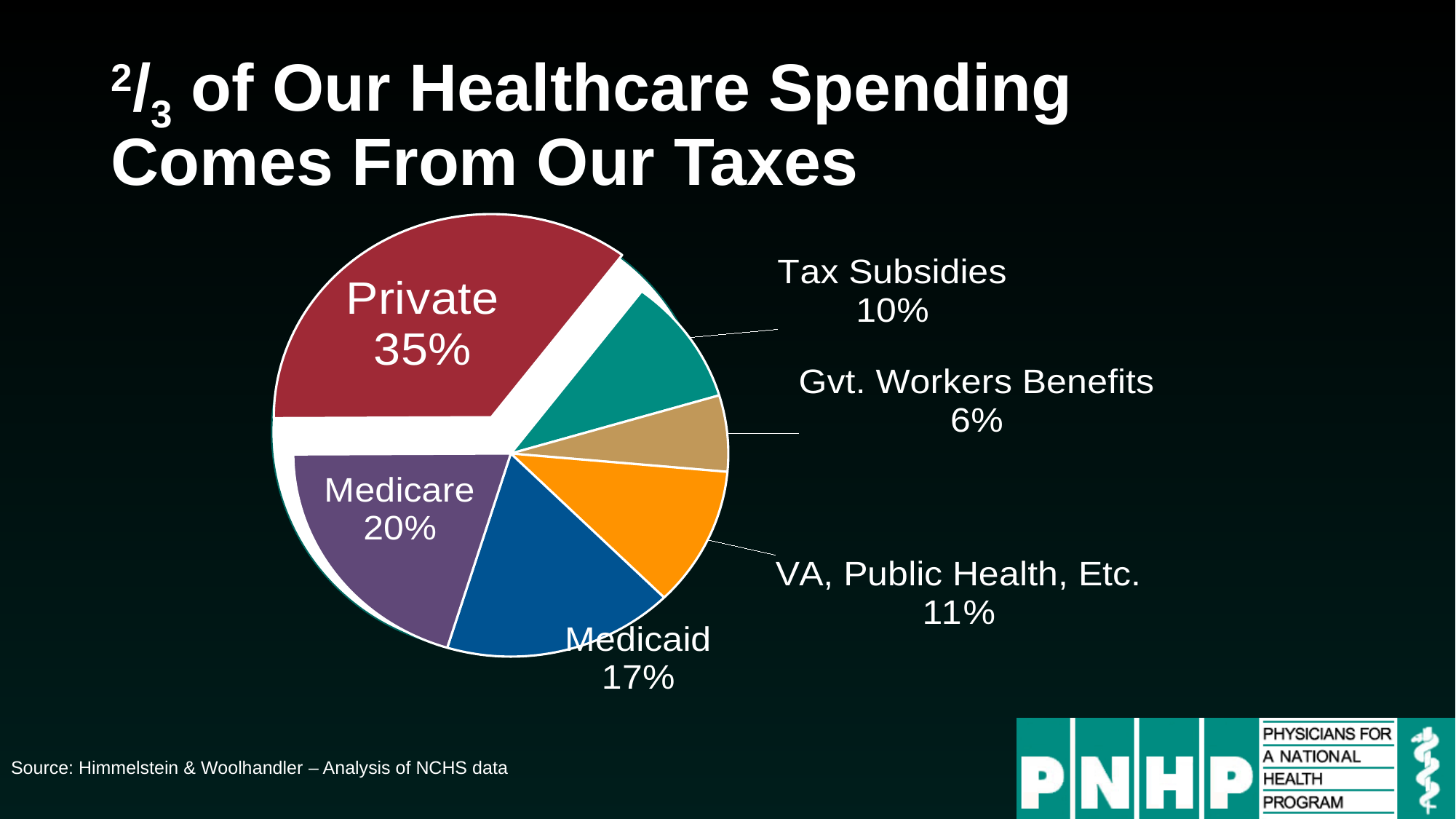
What share of healthcare spending is labelled as Private? 35% How many slices does the pie chart have? 6 What kind of chart is shown on the slide? Pie chart Which is larger, Medicaid or VA, Public Health, Etc.? Medicaid What is the difference in percentage points between Private and Medicare? 15 What percentage is shown for Medicare? 20% What percentage is shown for Gvt. Workers Benefits? 6% What percentage is shown for Medicaid? 17% What percentage is shown for VA, Public Health, Etc.? 11% What percentage is shown for Tax Subsidies? 10% Which slice of the pie is the largest? Private Which slice of the pie is the smallest? Gvt. Workers Benefits